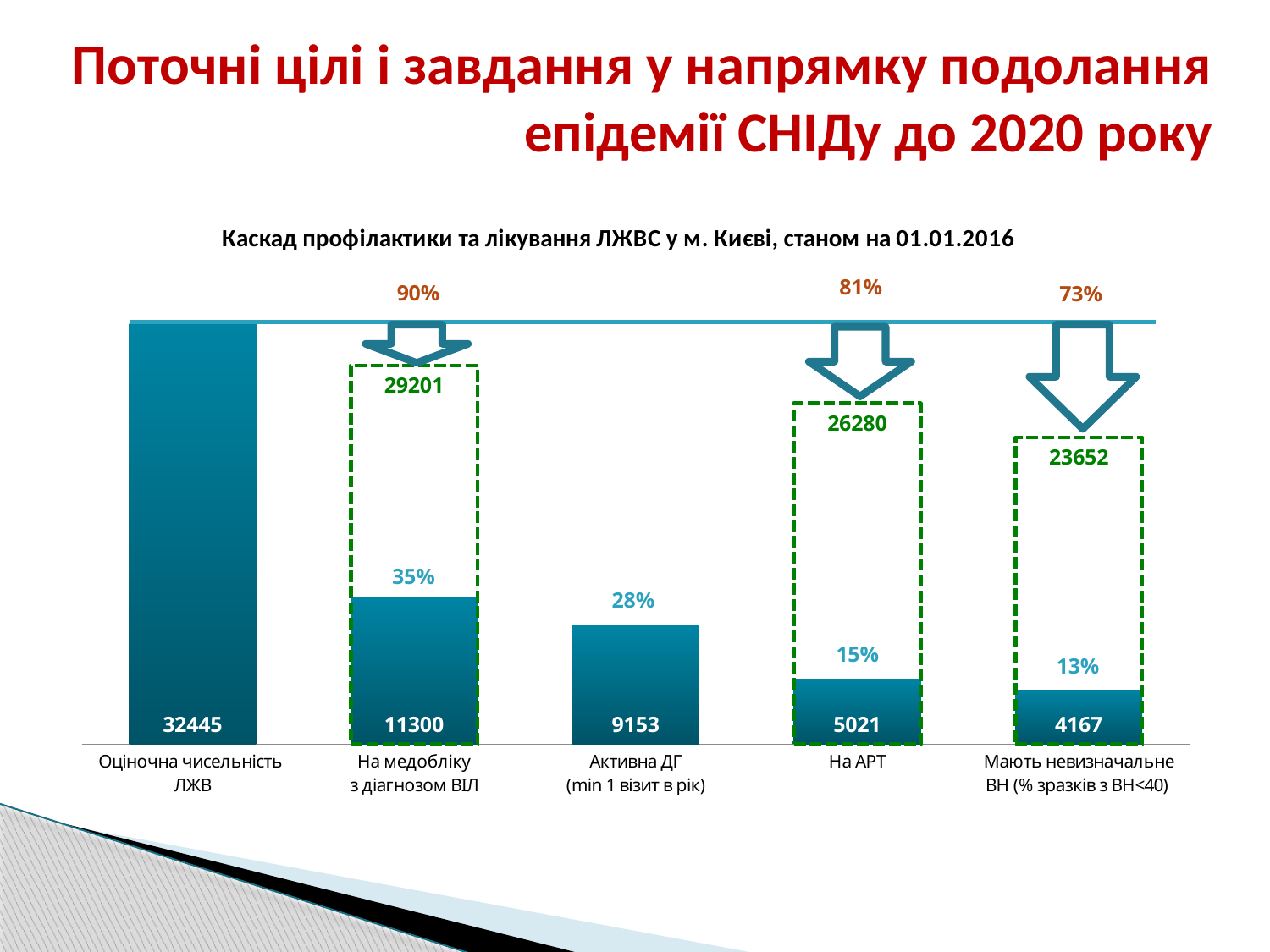
What is the value for "Активна ДГ (min 1 візит в рік)"? 9153 Which category has the lowest value? Мають невизначальне ВН (% зразків з ВН<40) What is the value for "На медобліку з діагнозом ВІЛ"? 11300 What target value is shown in the dashed box above "На АРТ"? 26280 What is the value for "Оціночна чисельність ЛЖВ"? 32445 What is the value for "Мають невизначальне ВН (% зразків з ВН<40)"? 4167 Which is larger: the value for "На АРТ" or the value for "Мають невизначальне ВН (% зразків з ВН<40)"? На АРТ What is the difference between the value for "На медобліку з діагнозом ВІЛ" and the value for "Активна ДГ (min 1 візит в рік)"? 2147 How many categories are shown on the x axis? 5 Which category has the highest value? Оціночна чисельність ЛЖВ What is the value for "На АРТ"? 5021 What kind of chart is shown on the slide? Bar chart